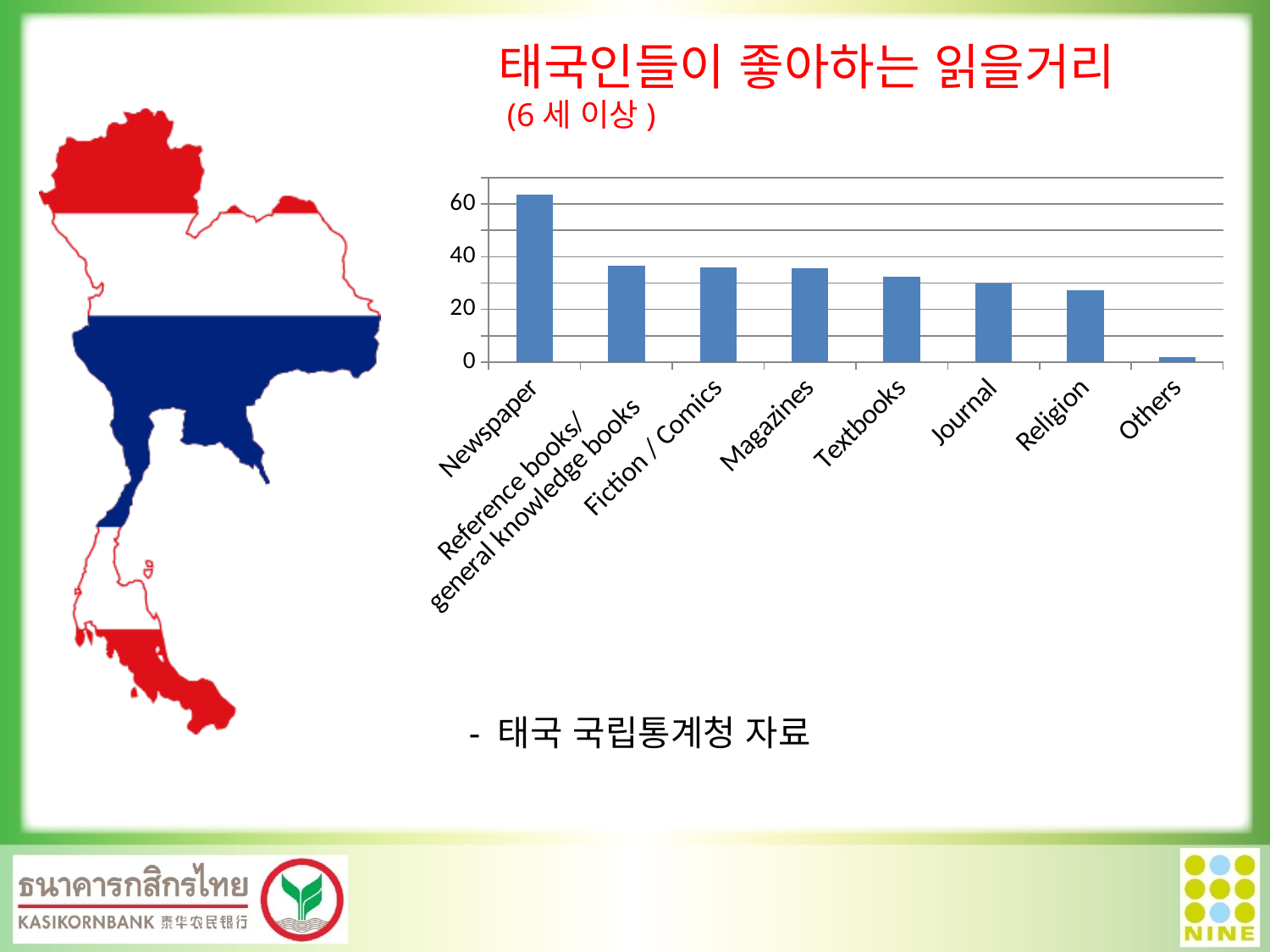
How many categories are shown on the x axis of the chart? 8 What kind of chart is shown on the slide? bar chart What is the label of the first category on the x axis? Newspaper Is the value for Others greater or less than 10? less Which category has the lowest bar in the chart? Others Which is larger, the value for Religion or the value for Others? Religion Which is larger, the value for Newspaper or the value for Journal? Newspaper Is the value for Religion greater or less than 20? greater Is the value for Textbooks greater or less than 40? less Do the bar values generally rise or fall from left to right along the x axis? fall Which category has the highest bar in the chart? Newspaper